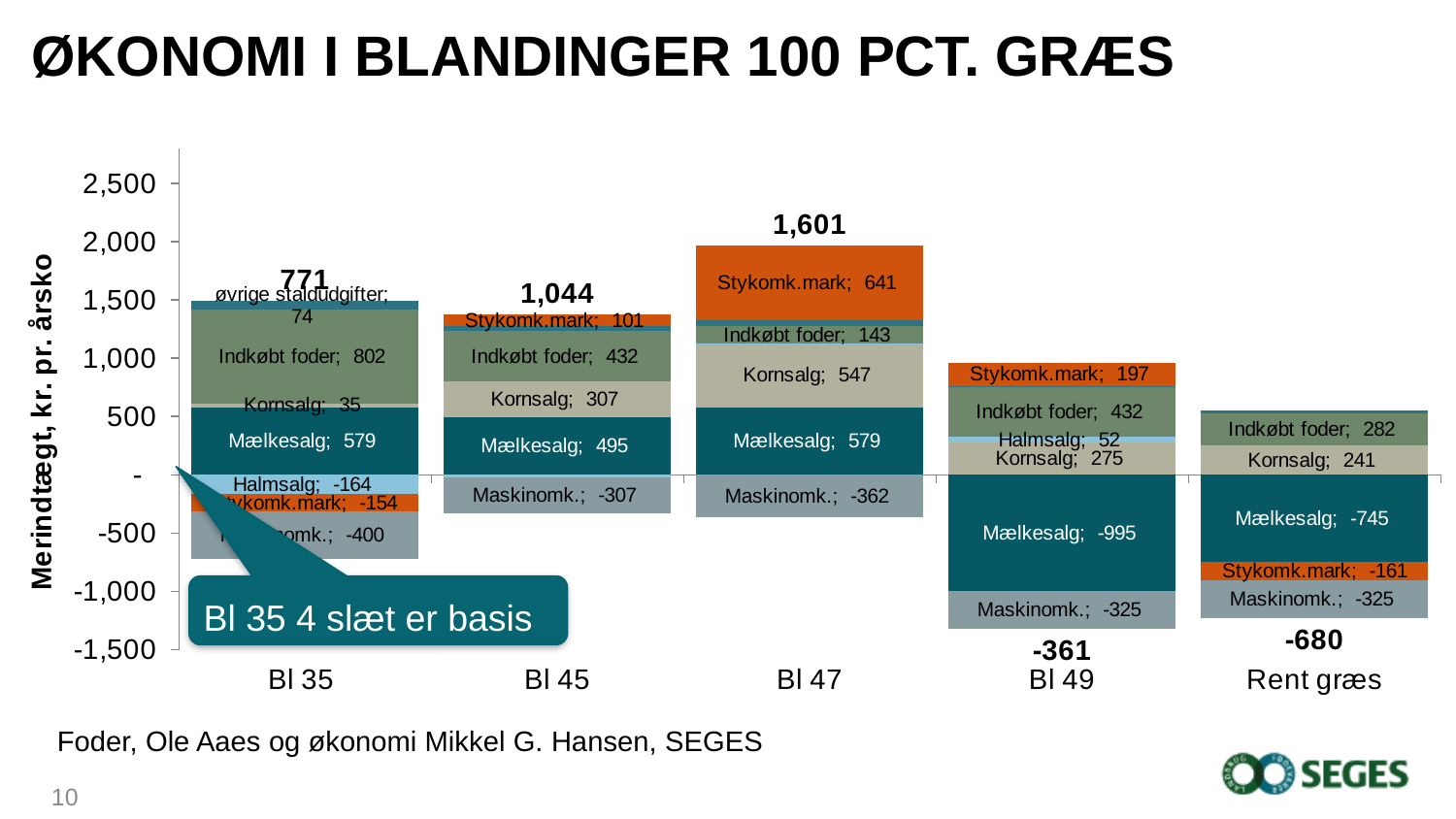
What is the Mælkesalg value for Bl 45? 495 Which category has the lowest total value? Rent græs What is the total value shown above the Bl 47 bar? 1,601 What is the Stykomk.mark value for Bl 47? 641 What is the label on the y axis? Merindtægt, kr. pr. årsko What is the difference between the total for Bl 47 and the total for Bl 45? 557 What is the Maskinomk. value for Bl 49? -325 How many categories are shown on the x axis? 5 Which has the larger Indkøbt foder value, Bl 35 or Bl 45? Bl 35 What is the Indkøbt foder value for Rent græs? 282 What kind of chart is shown on the slide? Stacked bar chart Which category has the highest total value? Bl 47